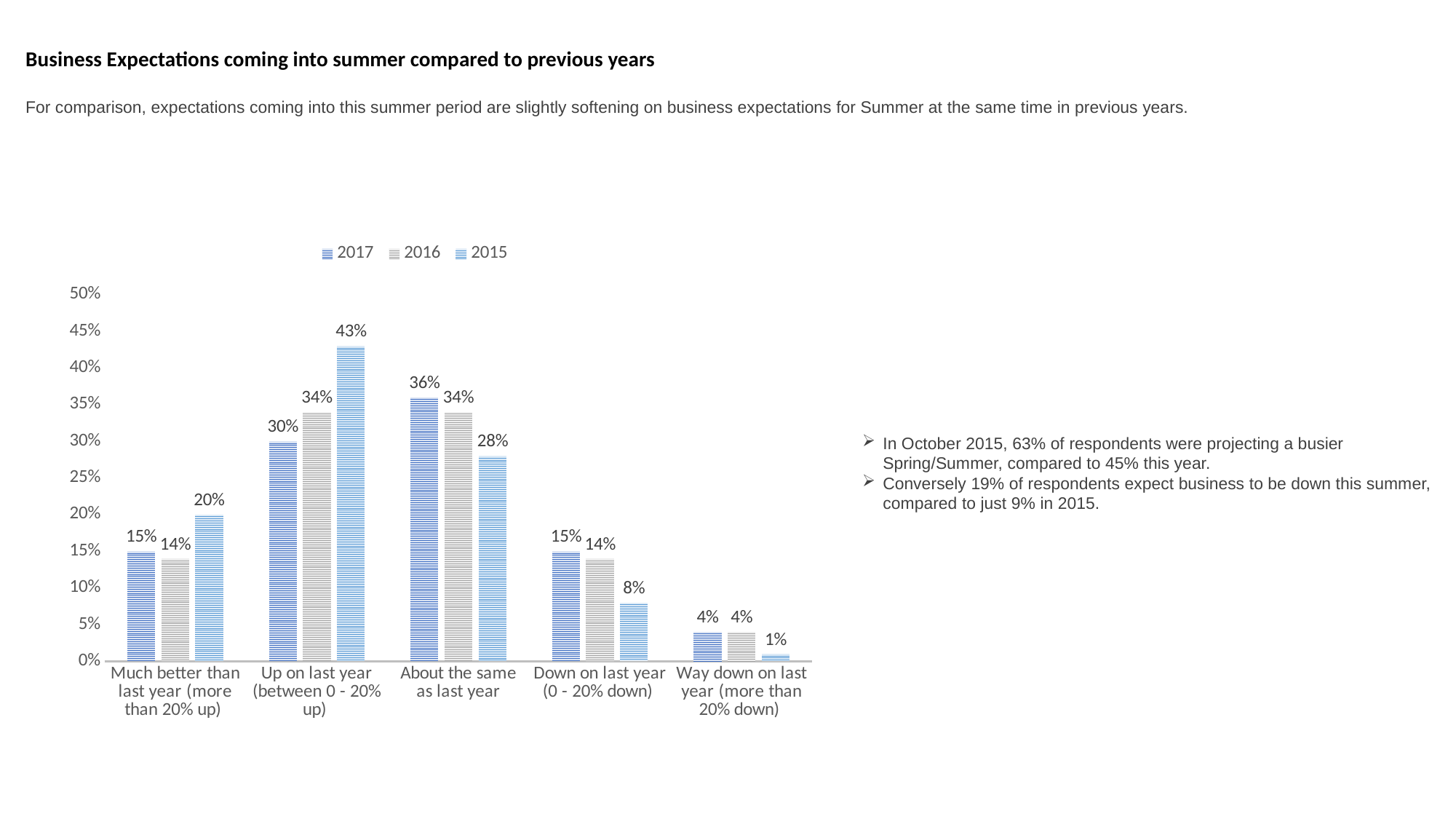
Which is larger for 'Much better than last year (more than 20% up)': the 2017 value or the 2015 value? 2015 What is the 2016 value for 'Down on last year (0 - 20% down)'? 14% How many categories are shown on the x axis? 5 Which category has the lowest 2017 value? Way down on last year (more than 20% down) What is the 2015 value for 'Up on last year (between 0 - 20% up)'? 43% What is the 2017 value for 'About the same as last year'? 36% What is the difference between the 2015 and 2017 values for 'Up on last year (between 0 - 20% up)'? 13% What kind of chart is shown on the slide? Bar chart How many series does the legend list? 3 What is the 2015 value for 'Way down on last year (more than 20% down)'? 1% Which years are listed in the chart legend? 2017, 2016, 2015 Which category has the highest 2015 value? Up on last year (between 0 - 20% up)